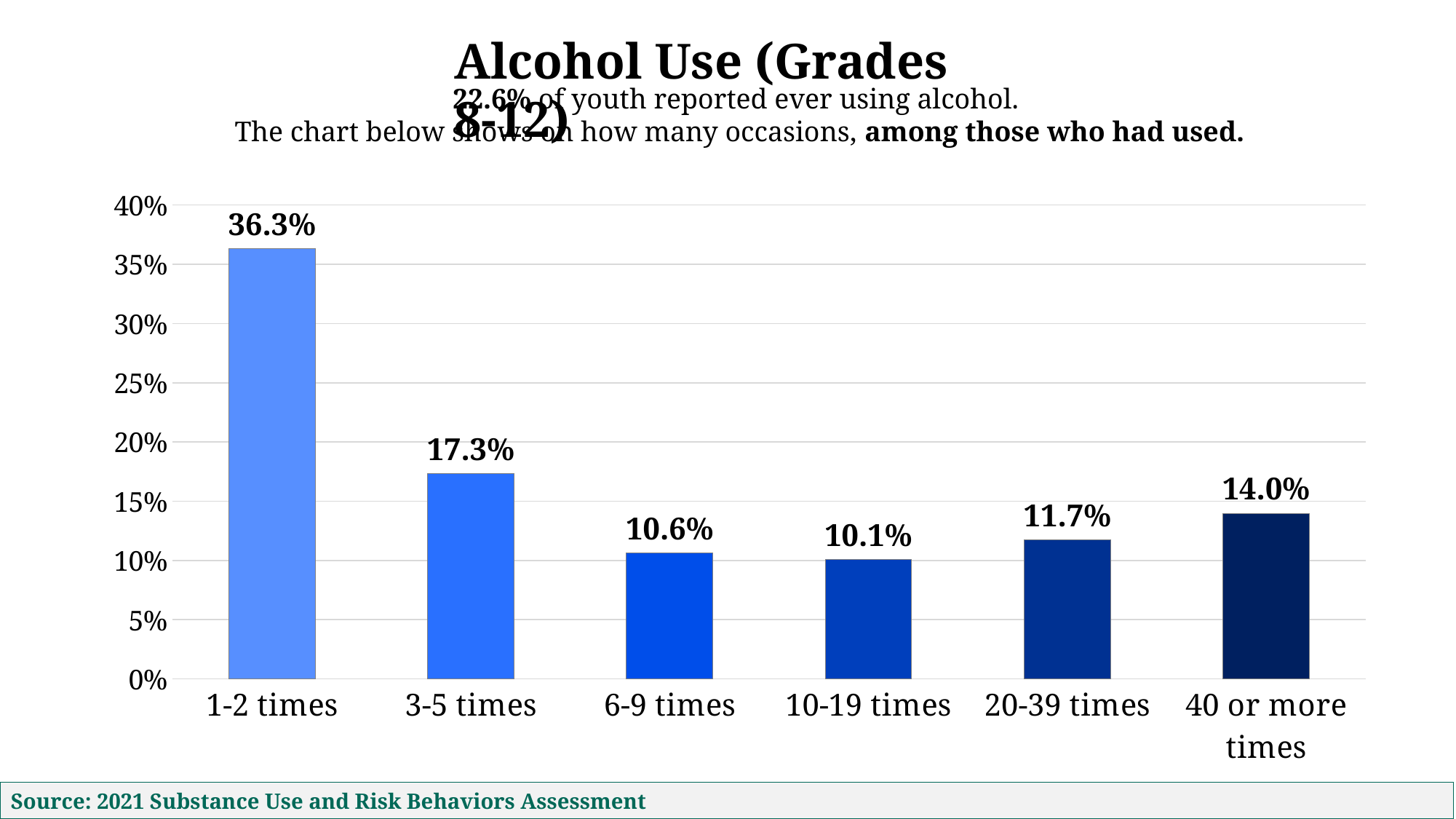
What kind of chart is shown on the slide? bar chart Which category has the lowest value? 10-19 times What percentage is shown for the 1-2 times category? 36.3% How many categories are shown on the x axis? 6 Which category has the highest value? 1-2 times What percentage is shown for 10-19 times? 10.1% Which is larger, the value for 6-9 times or the value for 20-39 times? 20-39 times What is the source cited at the bottom of the slide? 2021 Substance Use and Risk Behaviors Assessment What is the difference between the values for 40 or more times and 20-39 times? 2.3% What is the difference between the values for 1-2 times and 3-5 times? 19.0% What is the value for the 40 or more times category? 14.0% Is the value for 3-5 times greater or less than 20%? less